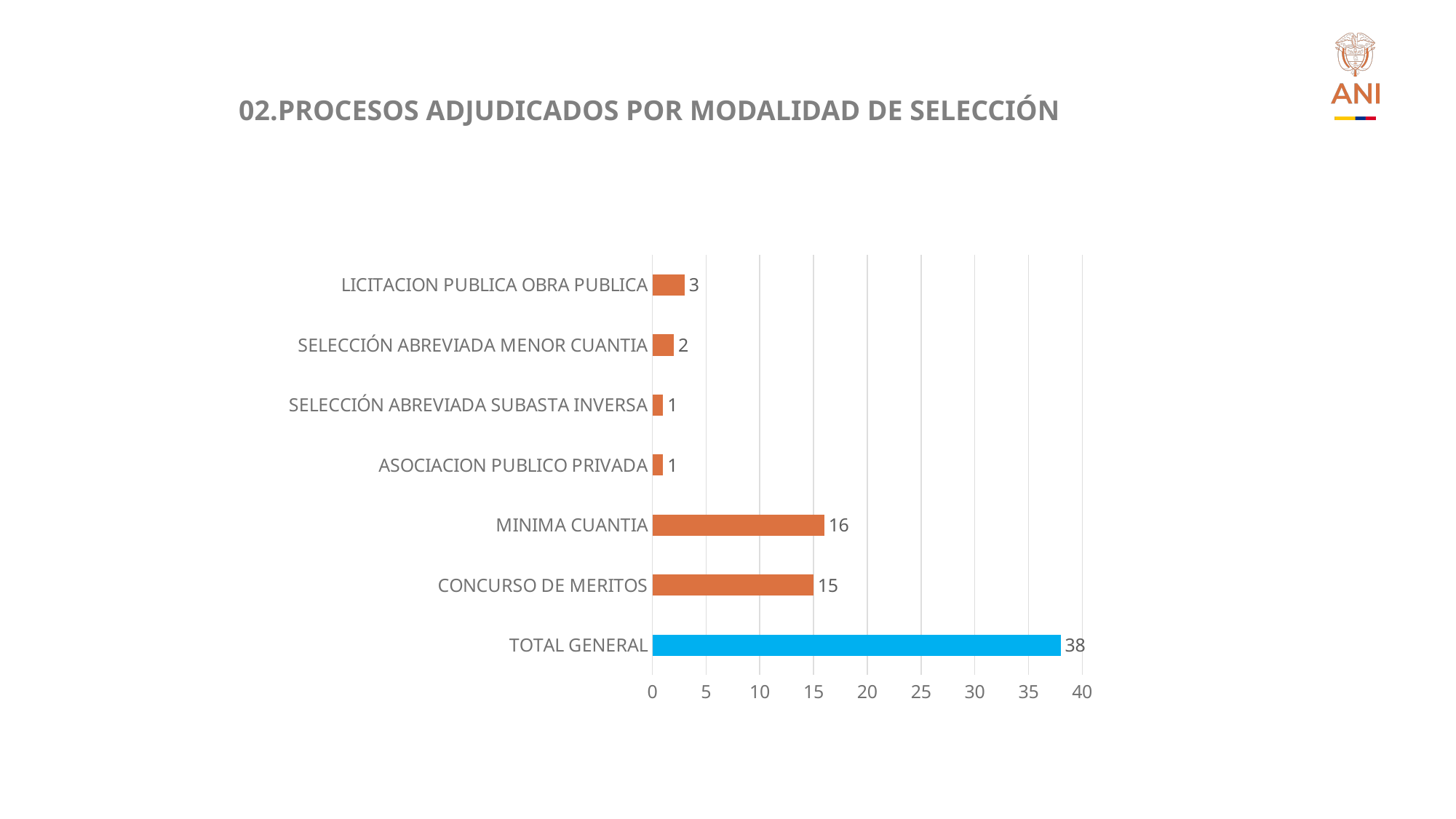
What is the title of the chart? 02.PROCESOS ADJUDICADOS POR MODALIDAD DE SELECCIÓN What is the difference between MINIMA CUANTIA and CONCURSO DE MERITOS? 1 What is the value for LICITACION PUBLICA OBRA PUBLICA? 3 What is the value for MINIMA CUANTIA? 16 Which is larger, LICITACION PUBLICA OBRA PUBLICA or SELECCIÓN ABREVIADA MENOR CUANTIA? LICITACION PUBLICA OBRA PUBLICA What is the value for TOTAL GENERAL? 38 What is the difference between TOTAL GENERAL and MINIMA CUANTIA? 22 How many categories are shown on the chart? 7 What is the value for CONCURSO DE MERITOS? 15 What kind of chart is shown on the slide? bar chart Excluding TOTAL GENERAL, which category has the highest value? MINIMA CUANTIA Is the value for TOTAL GENERAL greater or less than 35? greater